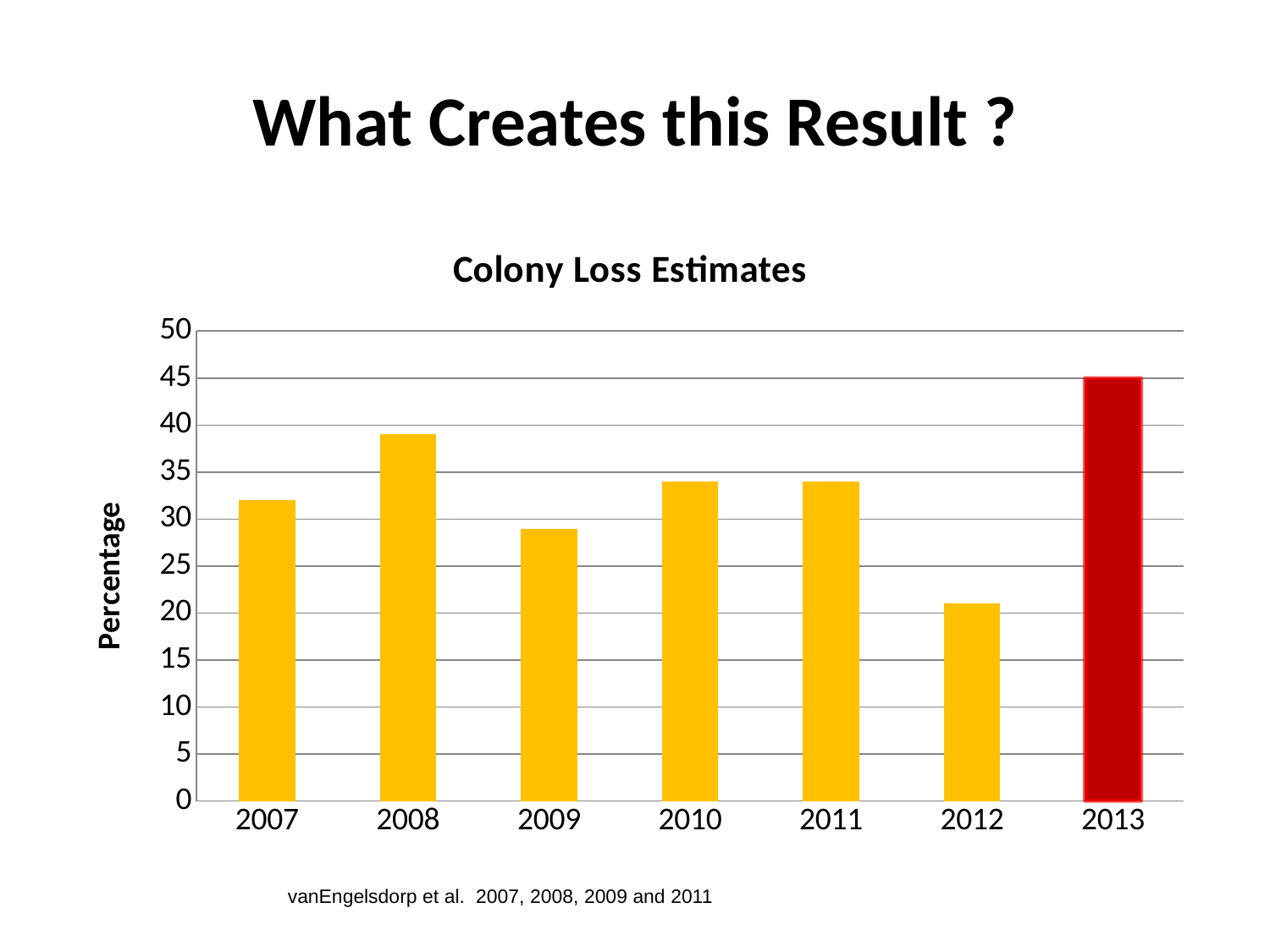
Which year has the larger colony loss estimate, 2007 or 2012? 2007 What kind of chart is shown on the slide? bar chart Which year has the lowest colony loss estimate? 2012 How many years are shown on the x axis of the Colony Loss Estimates chart? 7 Is the value for 2009 greater or less than 25? greater Is the value for 2013 greater or less than 40? greater What is the label on the y axis of the chart? Percentage Which year has the larger colony loss estimate, 2008 or 2009? 2008 Is the value for 2008 greater or less than 35? greater Which year has the highest colony loss estimate? 2013 What is the title of the chart? Colony Loss Estimates